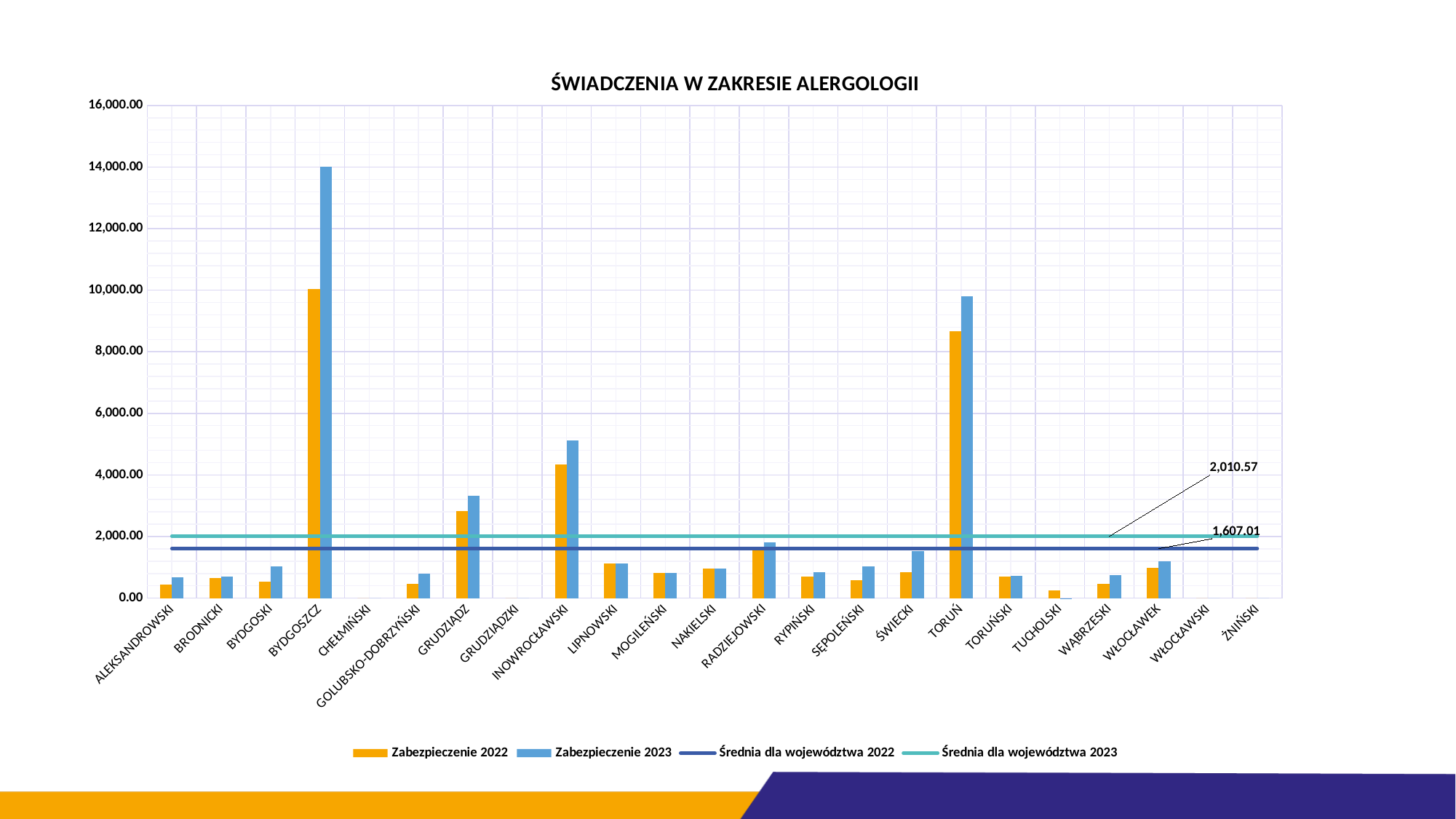
Which is larger, the Zabezpieczenie 2023 value for INOWROCŁAWSKI or for GRUDZIĄDZ? INOWROCŁAWSKI Is the Zabezpieczenie 2022 value for LIPNOWSKI greater or less than 2,000.00? less How many categories are shown on the x axis? 23 Is the Zabezpieczenie 2023 value for BYDGOSZCZ greater or less than 12,000.00? greater What is the difference between the Średnia dla województwa 2023 and Średnia dla województwa 2022 values? 403.56 What is the title of the chart? ŚWIADCZENIA W ZAKRESIE ALERGOLOGII What is the value of the Średnia dla województwa 2022 line? 1,607.01 What kind of chart is shown on the slide? combination bar and line chart What is the value of the Średnia dla województwa 2023 line? 2,010.57 How many series does the legend list? 4 Which category has the highest Zabezpieczenie 2023 value? BYDGOSZCZ Is the Zabezpieczenie 2022 value for TORUŃ greater or less than 8,000.00? greater